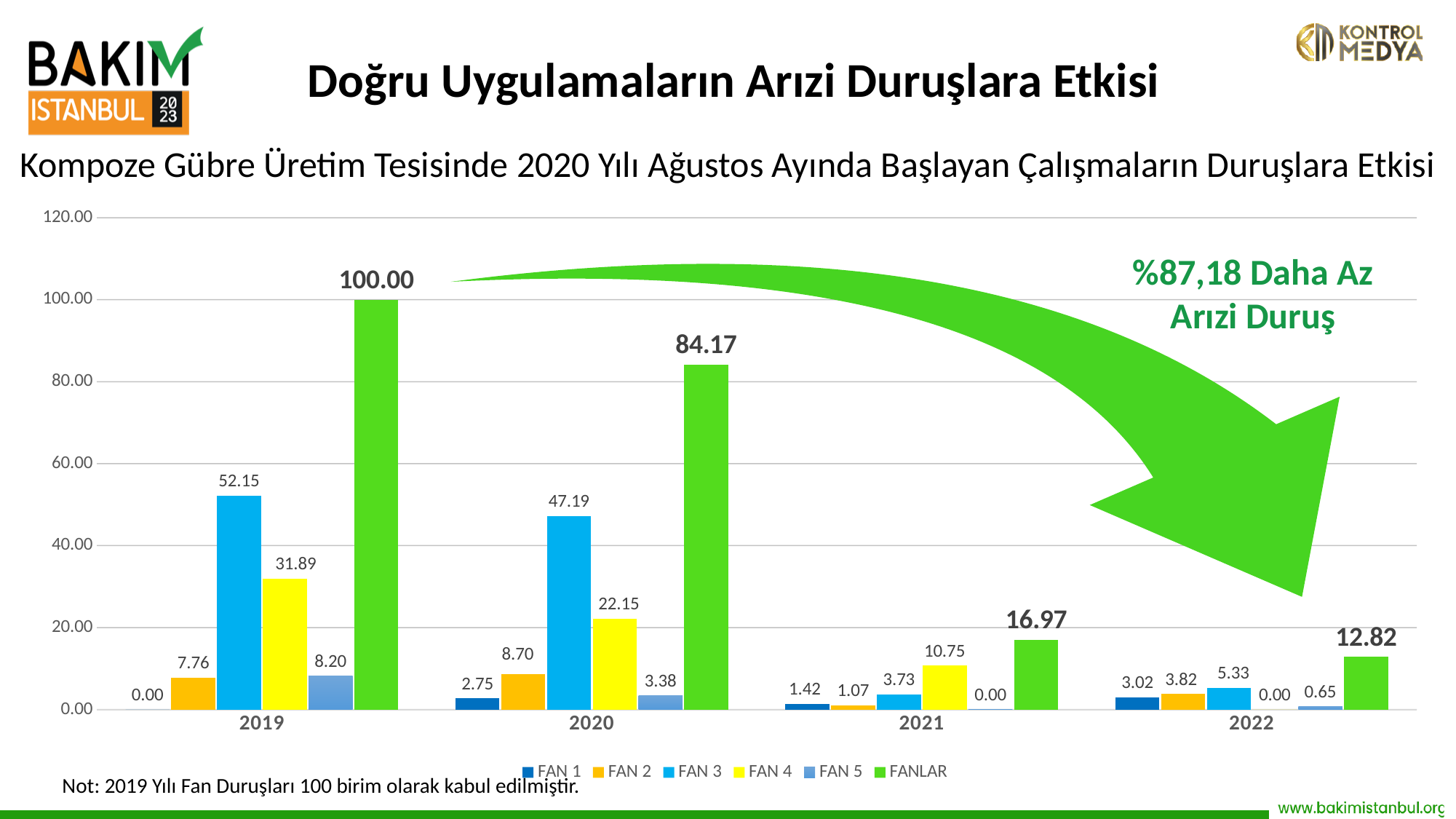
How many year categories are shown on the x axis? 4 In which year is the FANLAR value lowest? 2022 How many series does the legend list? 6 Which is larger, FAN 2 in 2020 or FAN 2 in 2022? FAN 2 in 2020 What type of chart is shown on the slide? bar chart What is the value of FAN 5 for 2022? 0.65 Do the FANLAR values rise or fall from 2019 to 2022? fall Which series has the highest value in 2020, excluding FANLAR? FAN 3 What is the value of FANLAR for 2020? 84.17 What is the difference between the FANLAR values for 2019 and 2022? 87.18 What is the value of FAN 3 for 2019? 52.15 What is the value of FAN 4 for 2021? 10.75